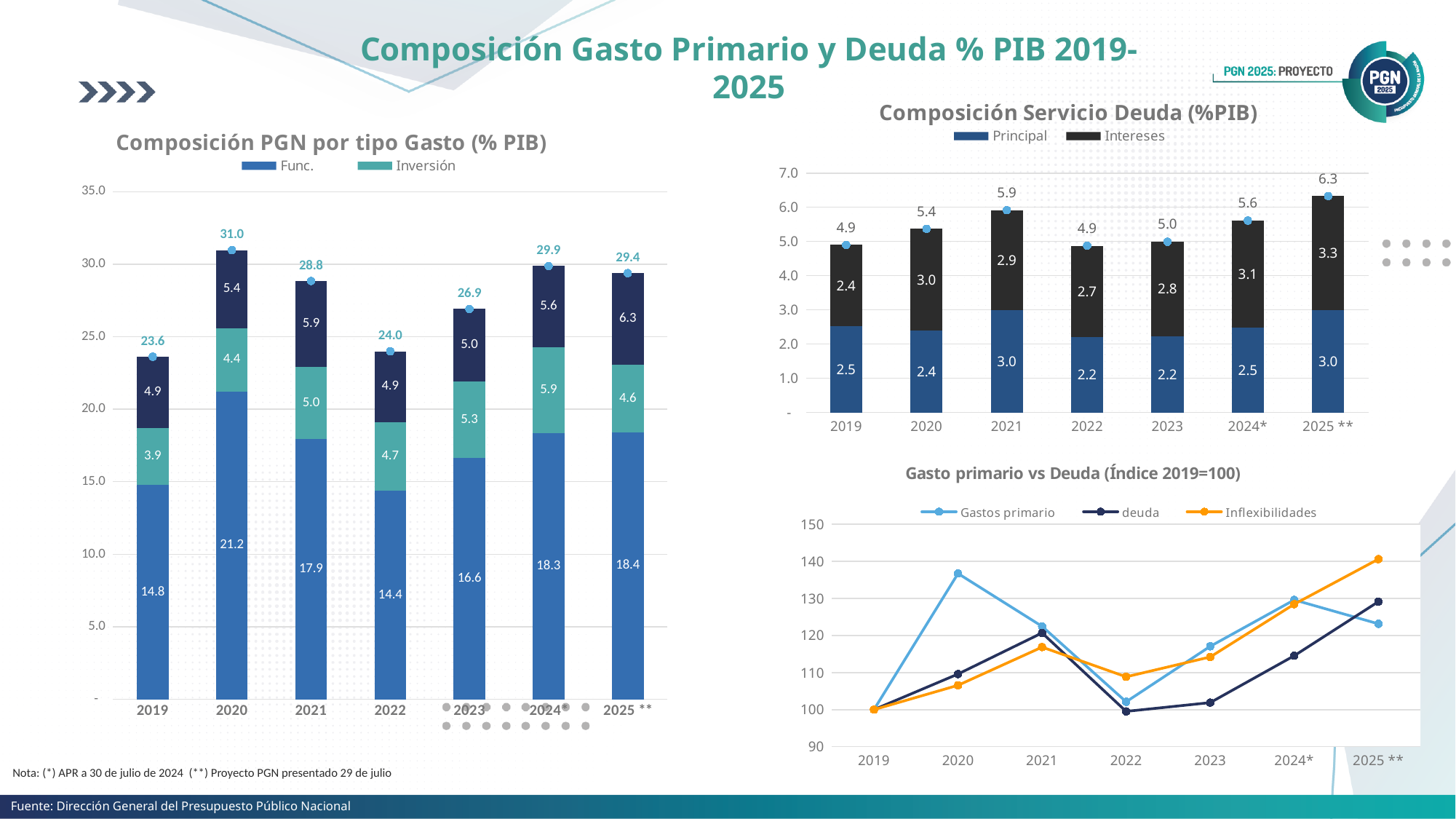
In the 'Composición PGN por tipo Gasto (% PIB)' chart, what is the total value for 2020? 31.0 In the 'Composición PGN por tipo Gasto (% PIB)' chart, what is the Func. value for 2021? 17.9 In the 'Composición Servicio Deuda (%PIB)' chart, how many series does the legend list? 2 In the 'Composición Servicio Deuda (%PIB)' chart, what is the Intereses value for 2025 **? 3.3 In the 'Composición PGN por tipo Gasto (% PIB)' chart, which year has the lowest total? 2019 In the 'Composición Servicio Deuda (%PIB)' chart, which year has the highest total? 2025 ** In the 'Composición Servicio Deuda (%PIB)' chart, is the Principal value for 2021 larger or smaller than the Principal value for 2022? larger What kind of chart is 'Gasto primario vs Deuda (Índice 2019=100)'? line chart In the 'Composición PGN por tipo Gasto (% PIB)' chart, what is the difference between the Inversión values for 2024* and 2025 **? 1.3 In the 'Gasto primario vs Deuda (Índice 2019=100)' chart, is the Inflexibilidades value for 2025 ** greater or less than 130? greater In the 'Gasto primario vs Deuda (Índice 2019=100)' chart, how many series does the legend list? 3 In the 'Composición Servicio Deuda (%PIB)' chart, what is the difference between the totals for 2021 and 2022? 1.0